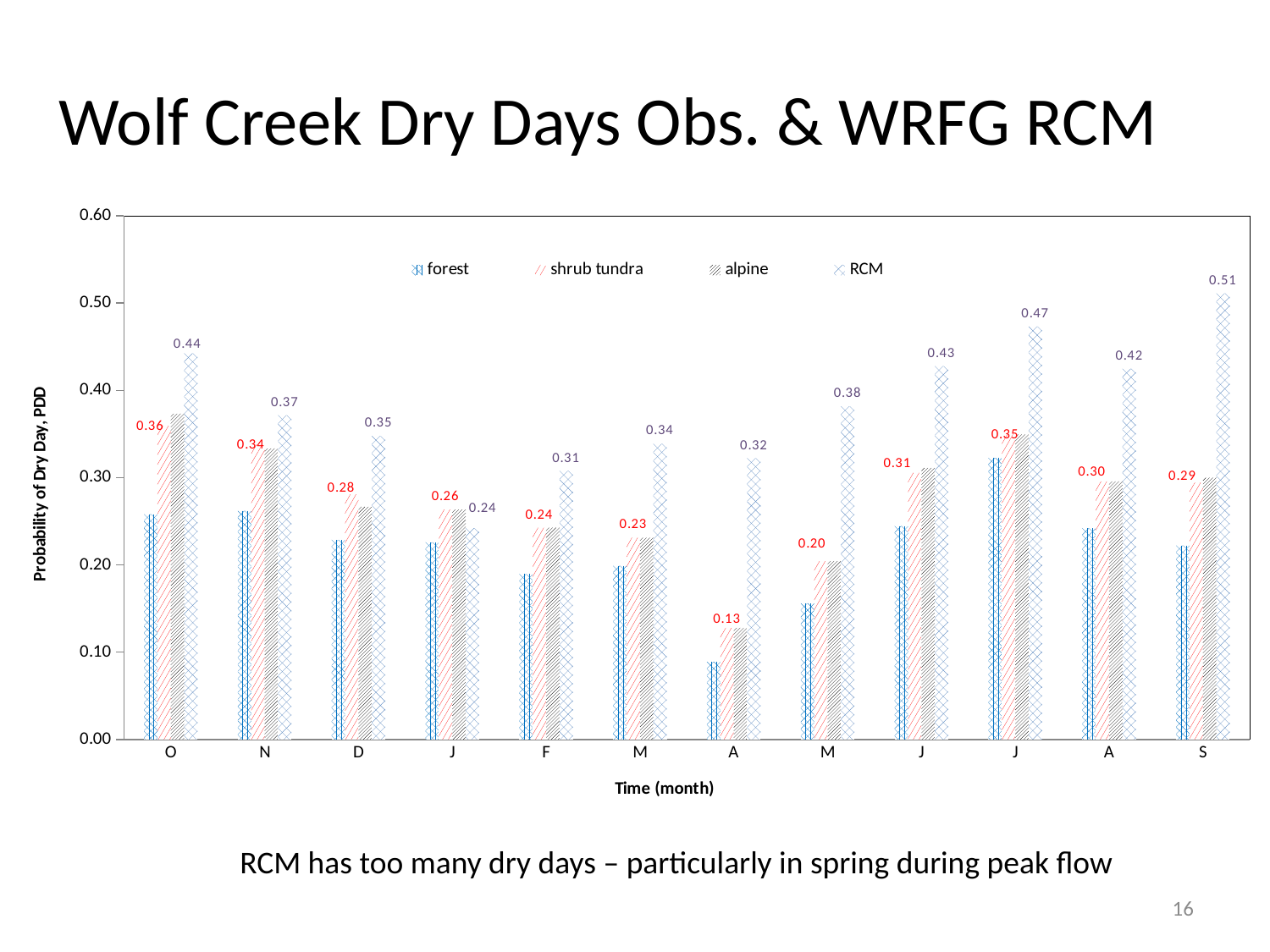
Which month has the lowest shrub tundra value? A (the seventh category) How many months are shown on the x axis? 12 What is the shrub tundra value for O? 0.36 What is the RCM value for S? 0.51 Do the shrub tundra values rise or fall from O to the first A? fall Is the alpine value for O greater or less than 0.30? greater What is the difference between the RCM and shrub tundra values for O? 0.08 What kind of chart is shown? bar chart Which month has the highest RCM value? S What is the RCM value for D? 0.35 Which has the larger RCM value, N or D? N How many series does the legend list? 4